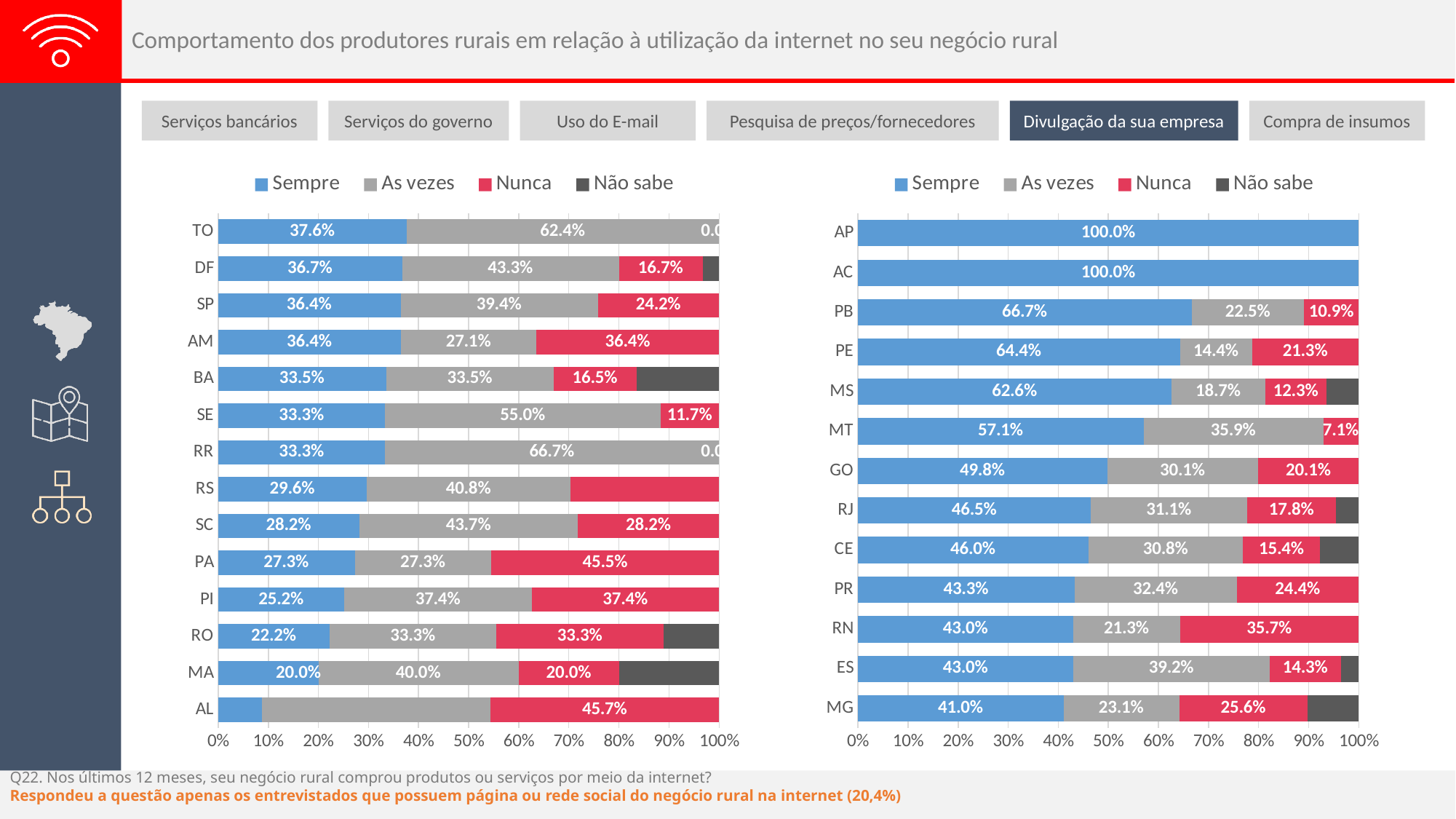
How many series does the legend of the right chart list? 4 In the right chart, what is the 'As vezes' value for MT? 35.9% In the right chart, which state has a larger 'Sempre' value, GO or RJ? GO In the right chart, what is the 'Nunca' value for PE? 21.3% In the left chart, what is the difference between the 'Sempre' and 'Nunca' values for DF? 20.0% How many states are shown in the right chart? 13 In the left chart, what is the 'Sempre' value for TO? 37.6% How many states are shown in the left chart? 14 In the right chart, which state has the lowest 'Sempre' value? MG In the left chart, which state has the highest 'As vezes' value? RR In the left chart, is the 'Sempre' value for AL greater or less than 20%? less What kind of chart is the left chart? Stacked bar chart